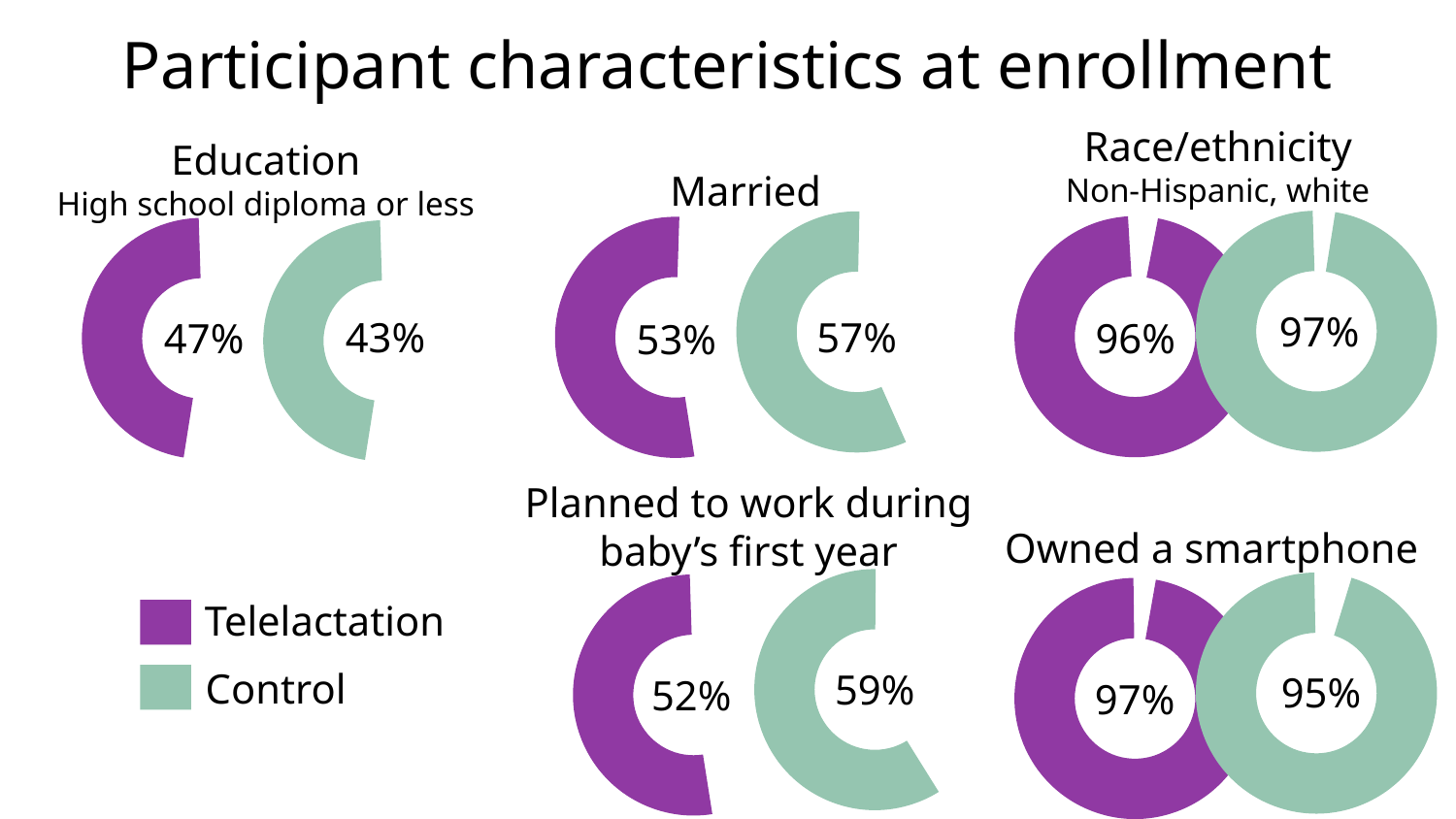
In the Married chart, what is the value for the Control group? 57% In the Owned a smartphone chart, what is the value for the Telelactation group? 97% In the Married chart, what is the difference between the Control and Telelactation values? 4% In the Planned to work during baby's first year chart, which group has the larger value, Telelactation or Control? Control In the Planned to work during baby's first year chart, what is the value for the Control group? 59% In the Education (High school diploma or less) chart, what is the value for the Control group? 43% In the Race/ethnicity (Non-Hispanic, white) chart, what is the value for the Telelactation group? 96% In the Education (High school diploma or less) chart, what is the value for the Telelactation group? 47% How many groups does the legend list? 2 In the Education (High school diploma or less) chart, which group has the larger value, Telelactation or Control? Telelactation In the Owned a smartphone chart, what is the difference between the Telelactation and Control values? 2% What kind of chart is used to show the participant characteristics on this slide? Donut chart